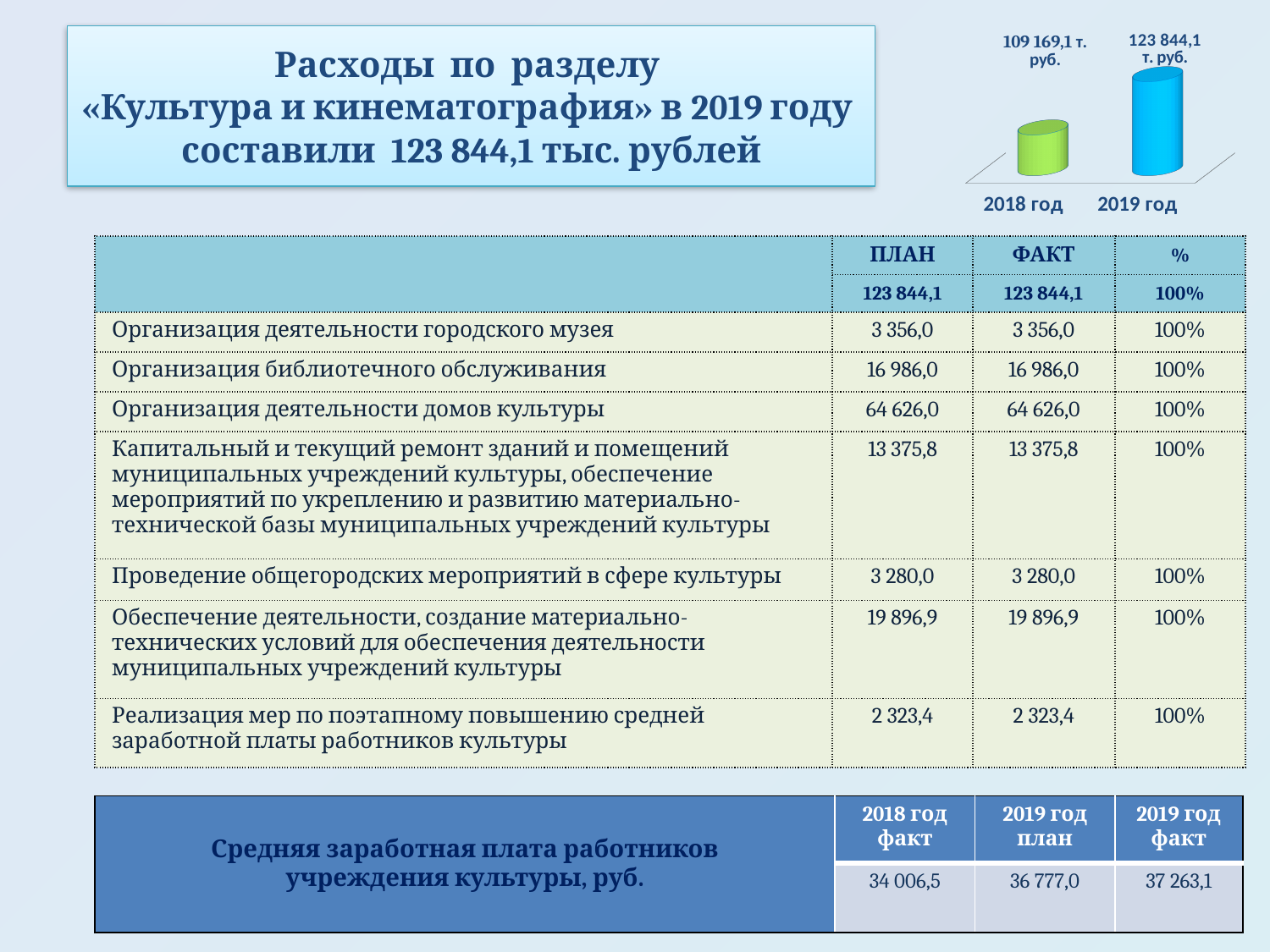
By how much does the 2019 год value exceed the 2018 год value in the chart? 14 675,0 т. руб. How many bars are plotted in the chart? 2 Which year has the higher value in the chart? 2019 год Which year has the lower value in the chart? 2018 год What colour is the bar for 2019 год in the chart? blue What colour is the bar for 2018 год in the chart? green Is the value for 2019 год larger or smaller than the value for 2018 год? larger What kind of chart is shown in the top right of the slide? bar chart Do the values in the chart rise or fall from 2018 год to 2019 год? rise What is the value shown for 2019 год in the chart? 123 844,1 т. руб. What is the value shown for 2018 год in the chart? 109 169,1 т. руб.